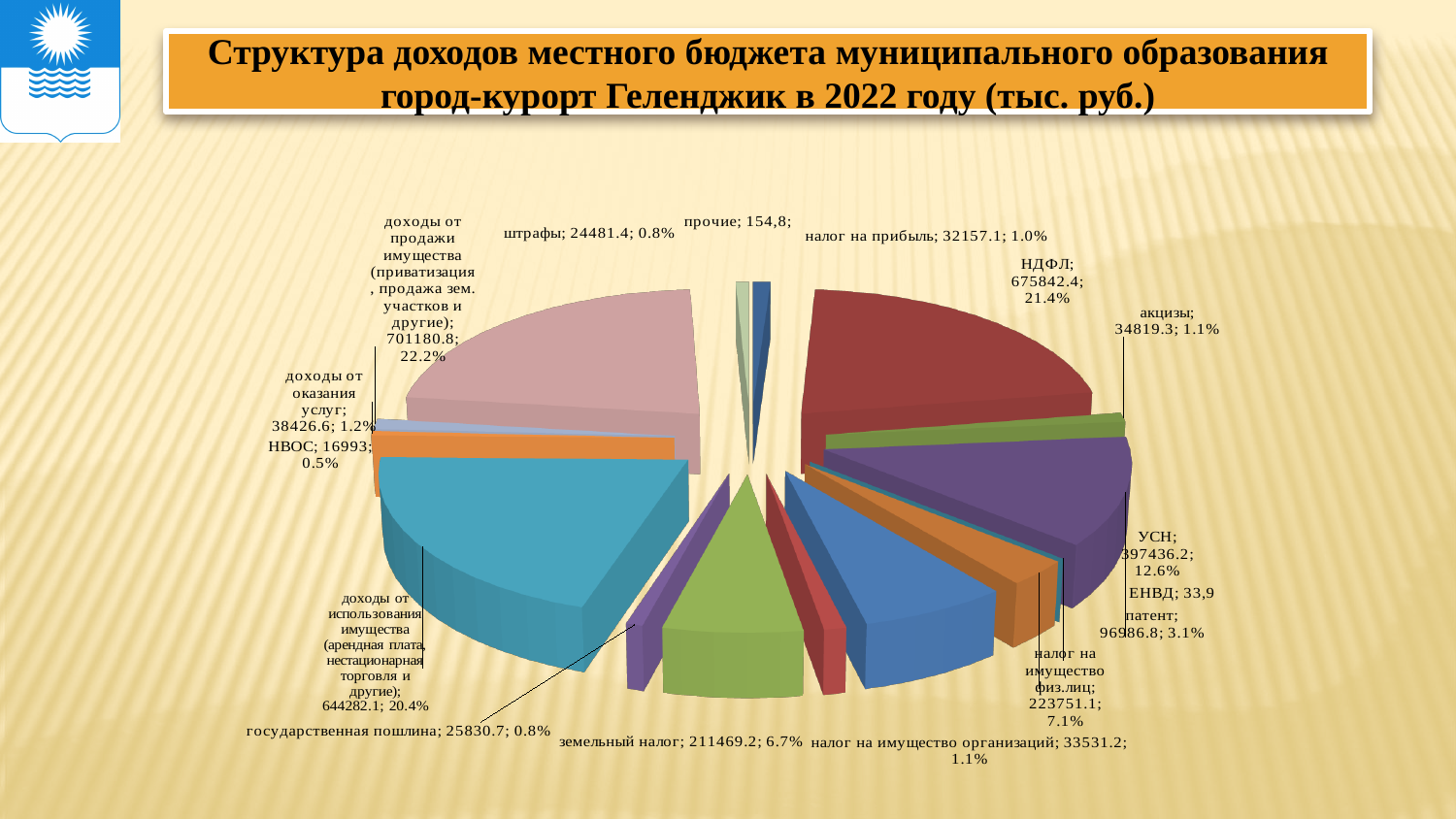
Which is larger: НДФЛ or доходы от использования имущества? НДФЛ What is the value for земельный налог? 211469.2 What is the value for НДФЛ? 675842.4 How many categories does the pie chart show? 16 Which category has the largest share of the pie? доходы от продажи имущества (приватизация, продажа зем. участков и другие) What is the title of the chart? Структура доходов местного бюджета муниципального образования город-курорт Геленджик в 2022 году (тыс. руб.) What share of the pie does УСН represent? 12.6% What is the value for патент? 96986.8 Which category has the smallest value? ЕНВД What kind of chart is shown on the slide? pie chart What is the difference between the values for акцизы and налог на прибыль? 2662.2 What share of the pie does налог на имущество физ.лиц represent? 7.1%